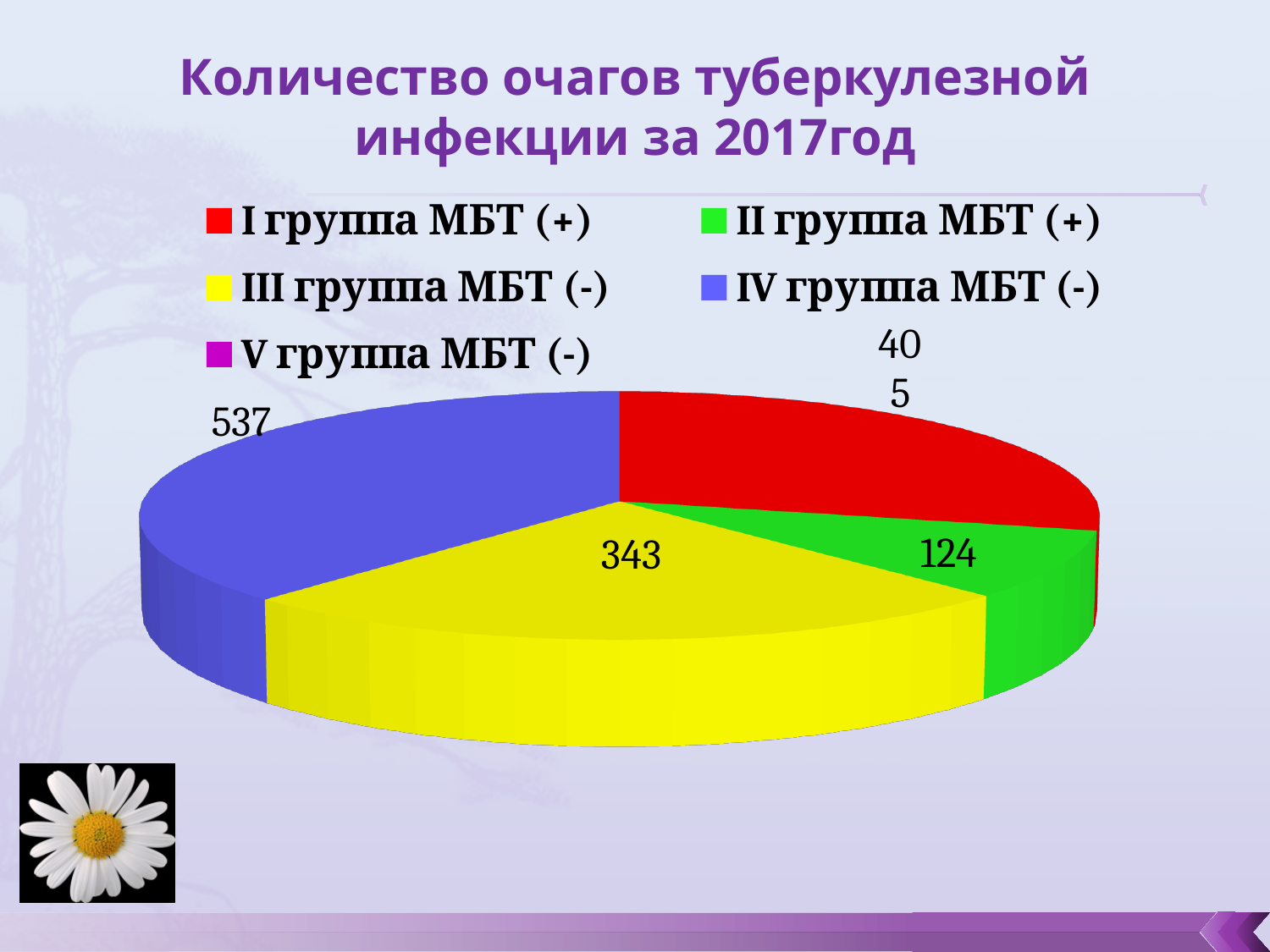
How many categories does the legend list? 5 What is the value for II группа МБТ (+)? 124 What is the value for III группа МБТ (-)? 343 What is the difference between the values for III группа МБТ (-) and II группа МБТ (+)? 219 What type of chart is shown on the slide? pie chart Which category has the largest slice of the pie? IV группа МБТ (-) What is the title of the chart? Количество очагов туберкулезной инфекции за 2017год Which colour represents IV группа МБТ (-) in the legend? blue What is the value for IV группа МБТ (-)? 537 Which is larger, III группа МБТ (-) or II группа МБТ (+)? III группа МБТ (-) What is the difference between the values for IV группа МБТ (-) and III группа МБТ (-)? 194